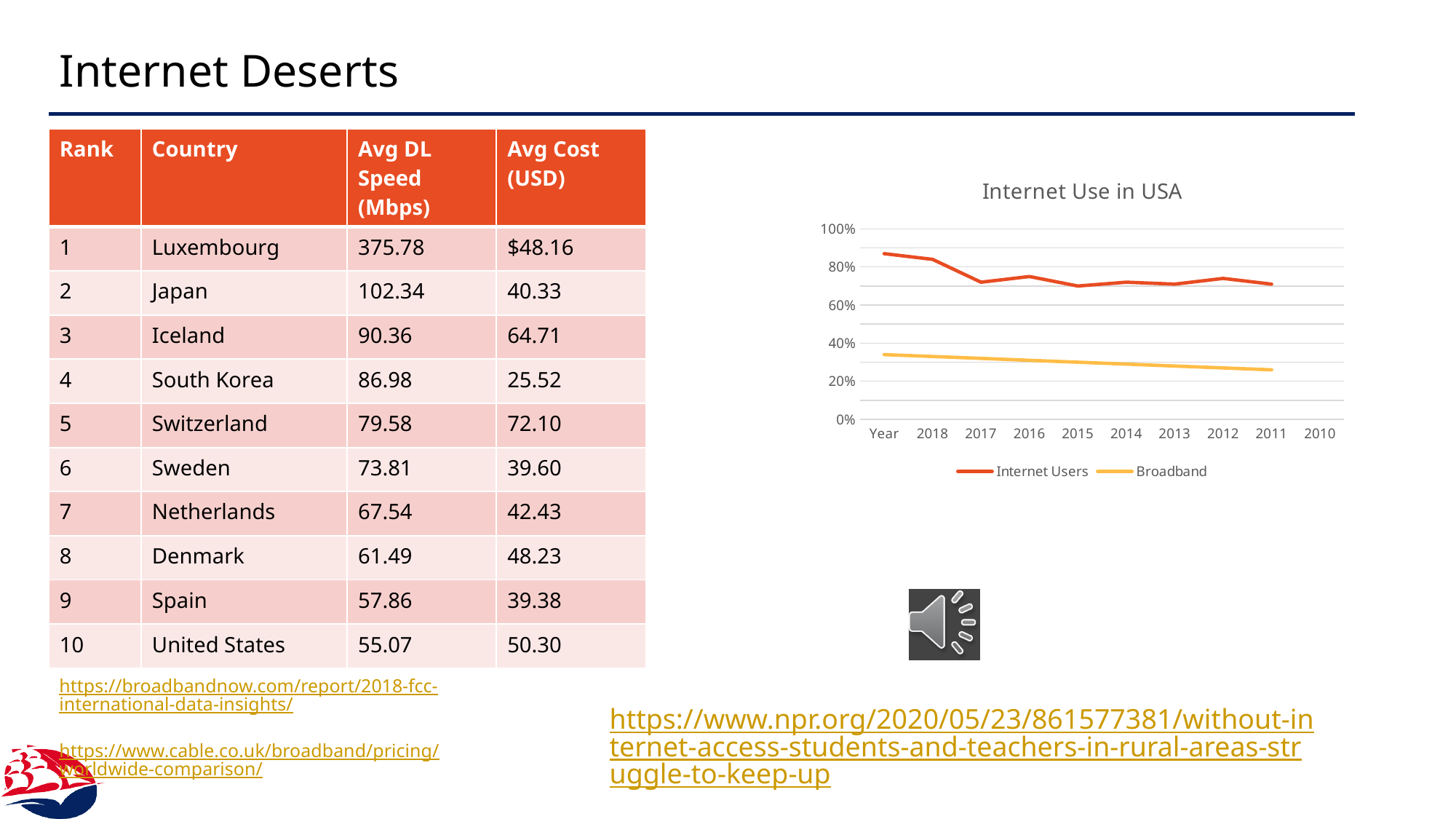
What are the two series named in the legend of the 'Internet Use in USA' chart? Internet Users and Broadband In the 'Internet Use in USA' chart, is the Internet Users value for 2015 greater or less than 60%? greater What kind of chart is 'Internet Use in USA'? line chart In the 'Internet Use in USA' chart, which series has the higher values throughout, Internet Users or Broadband? Internet Users In the 'Internet Use in USA' chart, is the Broadband value for 2011 greater or less than 40%? less In the 'Internet Use in USA' chart, is the Internet Users value for 2017 greater or less than 80%? less What is the title of the chart on the right side of the slide? Internet Use in USA In the 'Internet Use in USA' chart, which series is higher at 2015, Internet Users or Broadband? Internet Users In the 'Internet Use in USA' chart, does the Internet Users line rise or fall from left to right along the x axis? fall In the 'Internet Use in USA' chart, does the Broadband line rise or fall from left to right along the x axis? fall How many series does the legend of the 'Internet Use in USA' chart list? 2